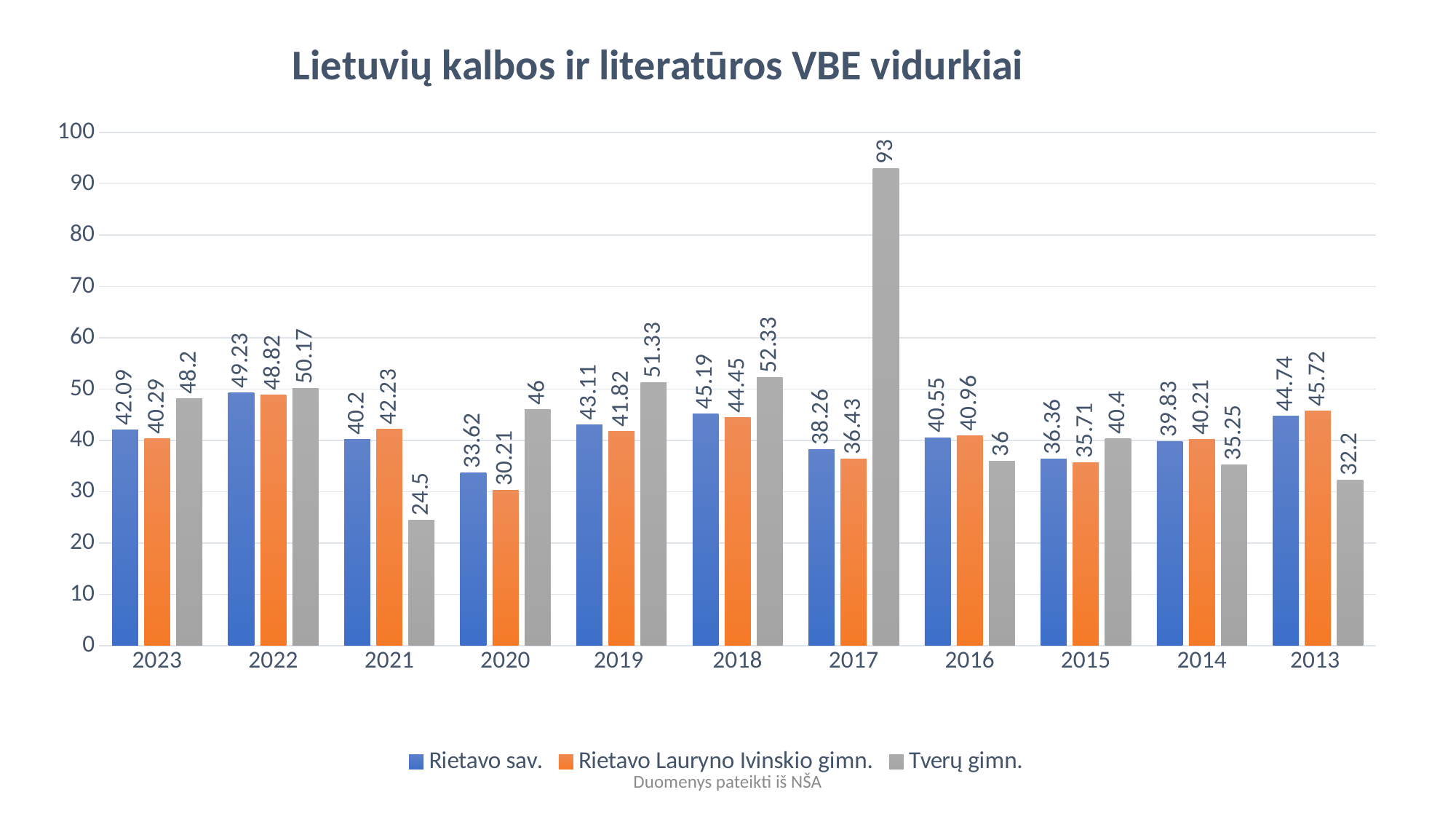
In which year is the value for Rietavo sav. the lowest? 2020 In 2013, which is larger: the value for Rietavo sav. or for Rietavo Lauryno Ivinskio gimn.? Rietavo Lauryno Ivinskio gimn. What is the value for Rietavo sav. in 2022? 49.23 How many series does the legend list? 3 What is the difference between the Tverų gimn. value and the Rietavo sav. value in 2017? 54.74 What is the difference between the Rietavo Lauryno Ivinskio gimn. value and the Tverų gimn. value in 2021? 17.73 What kind of chart is shown on the slide? Bar chart How many years are shown on the x axis? 11 In which year is the value for Tverų gimn. the lowest? 2021 What is the value for Tverų gimn. in 2017? 93 What is the value for Rietavo Lauryno Ivinskio gimn. in 2020? 30.21 In which year is the value for Tverų gimn. the highest? 2017